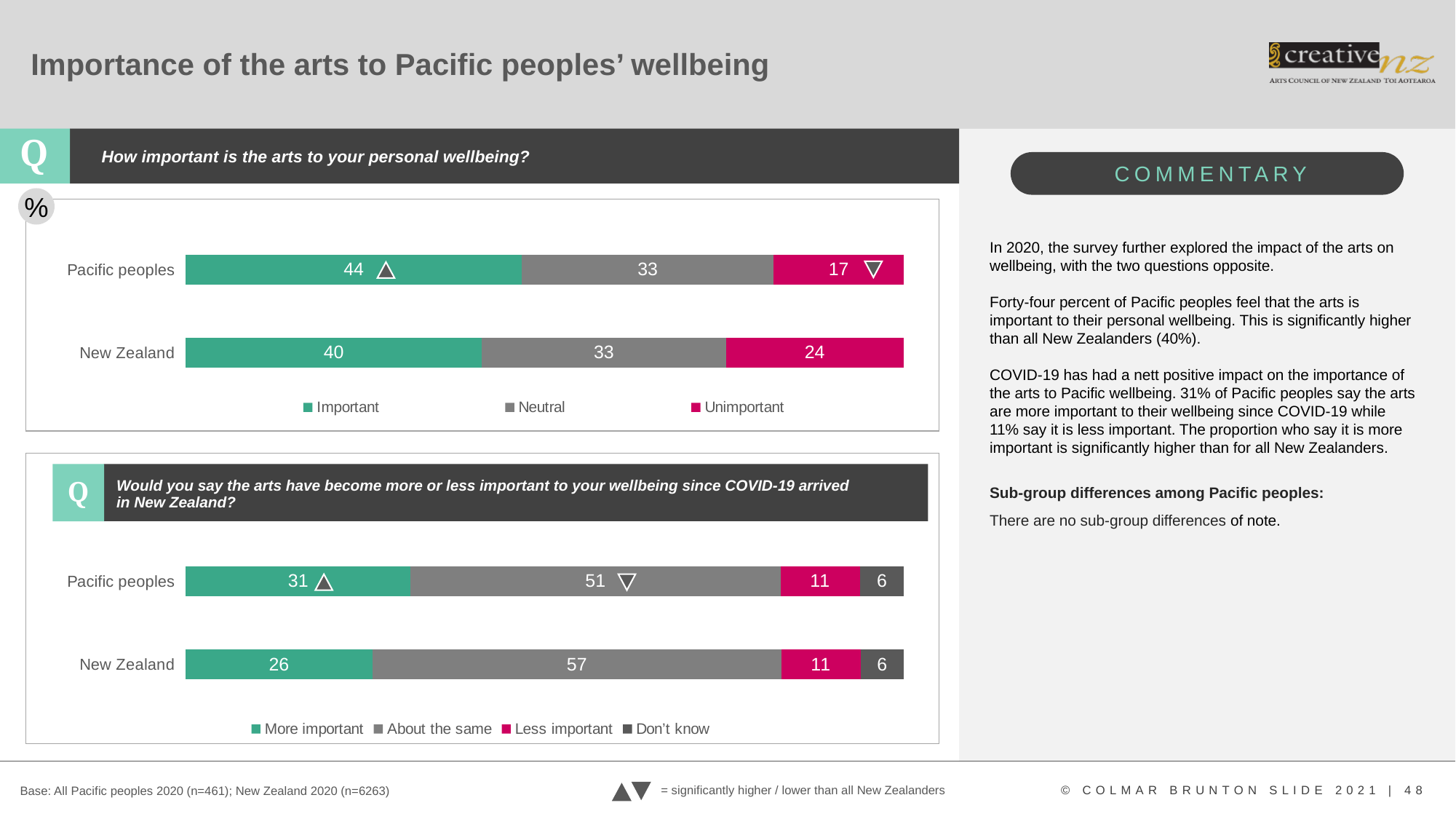
In the top chart (How important is the arts to your personal wellbeing?), what is the Unimportant value for New Zealand? 24 In the bottom chart (Would you say the arts have become more or less important to your wellbeing since COVID-19 arrived in New Zealand?), how many series does the legend list? 4 What type of chart is the top chart (How important is the arts to your personal wellbeing?)? Stacked bar chart In the top chart (How important is the arts to your personal wellbeing?), what is the difference between the Unimportant values for New Zealand and Pacific peoples? 7 In the top chart (How important is the arts to your personal wellbeing?), how many series does the legend list? 3 In the top chart (How important is the arts to your personal wellbeing?), what is the Important value for Pacific peoples? 44 In the bottom chart (Would you say the arts have become more or less important to your wellbeing since COVID-19 arrived in New Zealand?), which segment is the largest for Pacific peoples? About the same In the top chart (How important is the arts to your personal wellbeing?), which group has the larger Important value, Pacific peoples or New Zealand? Pacific peoples In the bottom chart (Would you say the arts have become more or less important to your wellbeing since COVID-19 arrived in New Zealand?), what is the About the same value for New Zealand? 57 In the bottom chart (Would you say the arts have become more or less important to your wellbeing since COVID-19 arrived in New Zealand?), which segment is the smallest for New Zealand? Don't know In the bottom chart (Would you say the arts have become more or less important to your wellbeing since COVID-19 arrived in New Zealand?), what is the difference between the More important values for Pacific peoples and New Zealand? 5 In the bottom chart (Would you say the arts have become more or less important to your wellbeing since COVID-19 arrived in New Zealand?), what is the More important value for Pacific peoples? 31